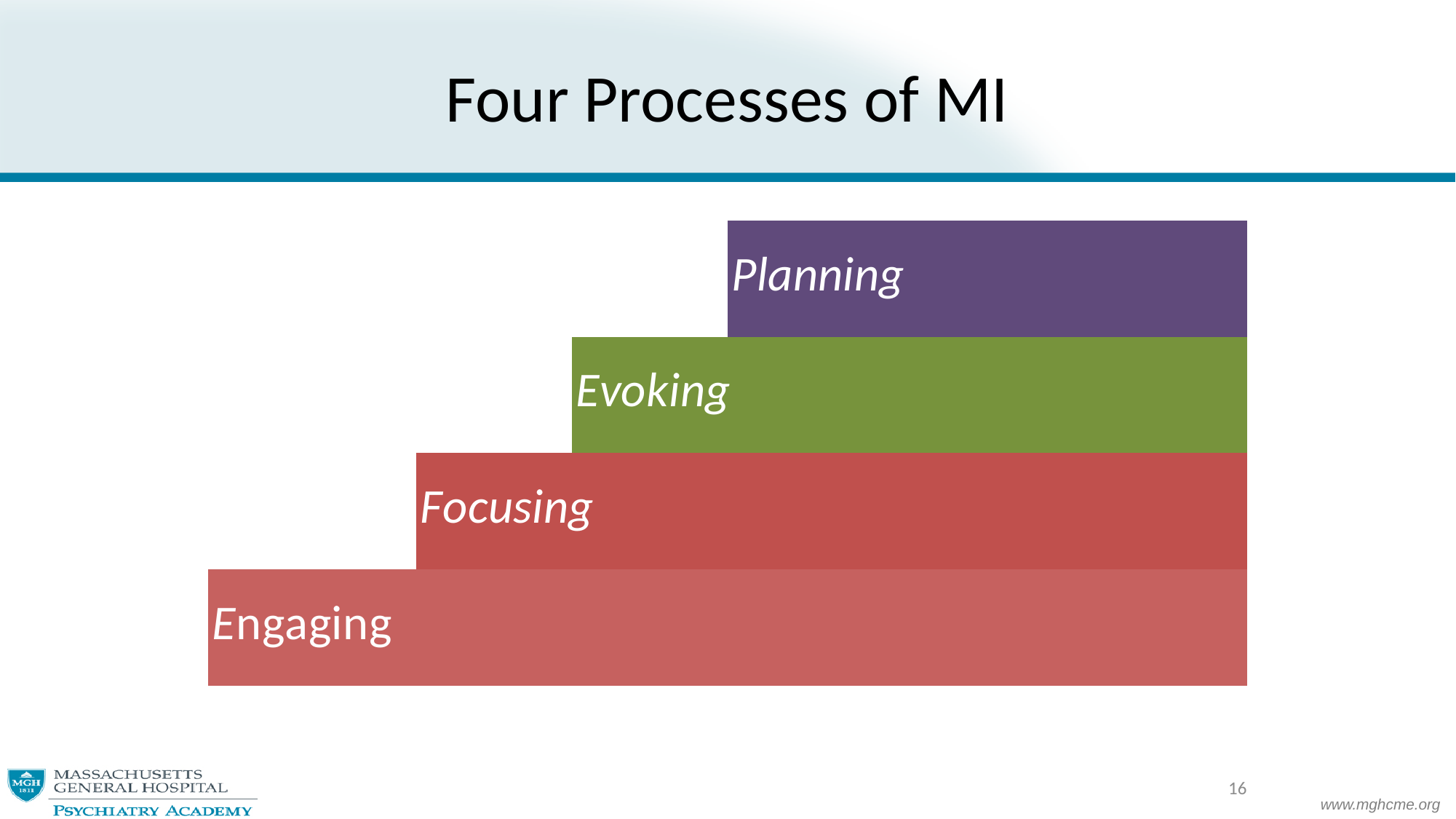
Which process is at the top of the diagram? Planning Which process is at the bottom of the diagram? Engaging How many processes are shown in the stacked diagram? 4 Which bar is longer, Focusing or Evoking? Focusing Do the bars get shorter or longer moving from the bottom of the diagram to the top? shorter What is the title of the slide? Four Processes of MI What colour is the Evoking bar? green Which bar is longer, Planning or Engaging? Engaging Which process has the longest bar in the diagram? Engaging Which process has the shortest bar in the diagram? Planning